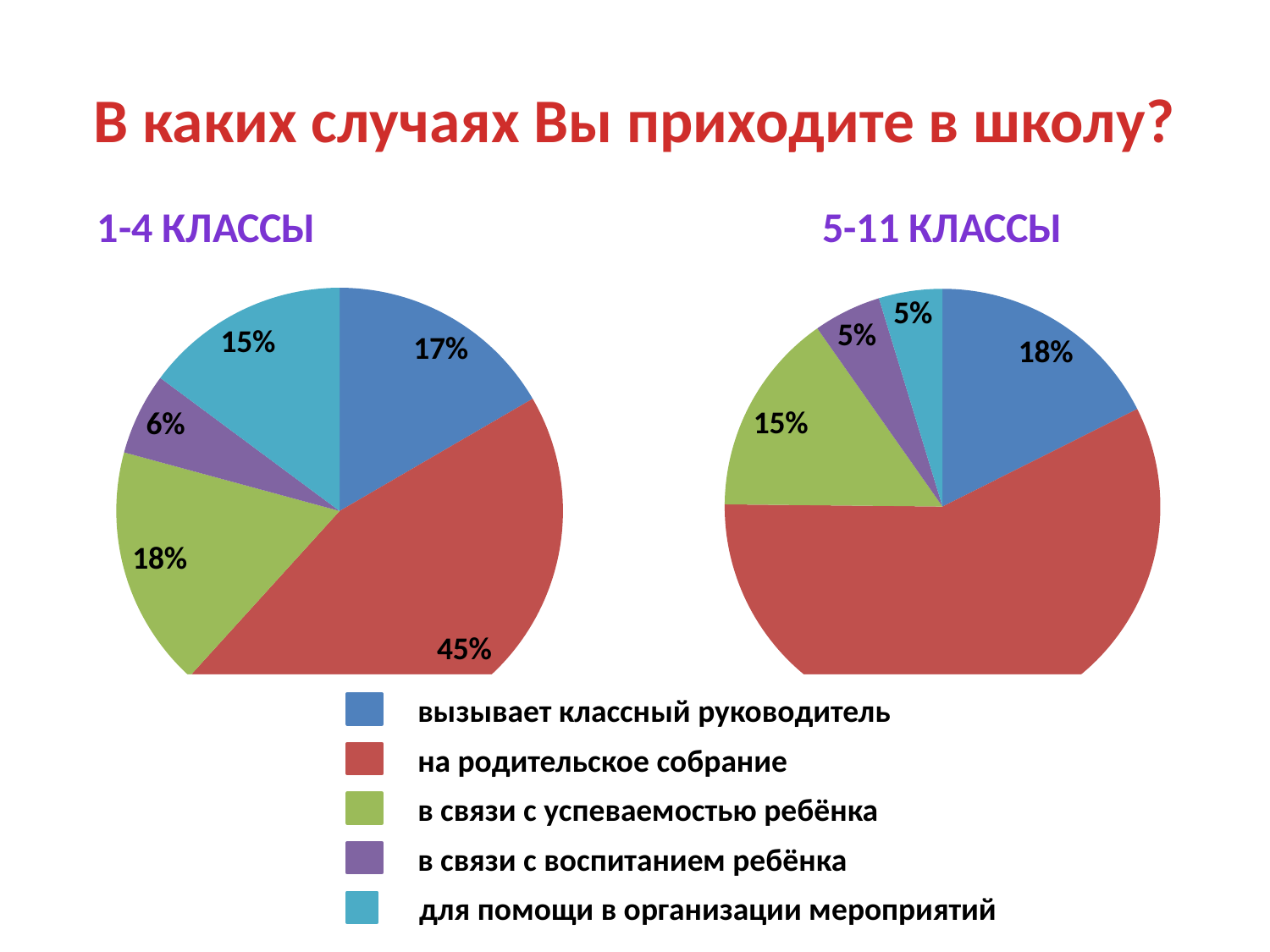
What colour represents 'для помощи в организации мероприятий' in the legend? cyan (light blue) In the 5-11 КЛАССЫ chart, what percentage is shown for 'вызывает классный руководитель'? 18% In the 1-4 КЛАССЫ chart, what is the difference in percentage points between 'на родительское собрание' and 'вызывает классный руководитель'? 28 How many categories does the legend list? 5 In the 1-4 КЛАССЫ chart, which category has the largest slice? на родительское собрание What kind of chart is used on the slide for the 1-4 КЛАССЫ data? pie chart In the 1-4 КЛАССЫ chart, which is larger: 'в связи с успеваемостью ребёнка' or 'для помощи в организации мероприятий'? в связи с успеваемостью ребёнка In the 1-4 КЛАССЫ chart, what percentage is shown for 'в связи с воспитанием ребёнка'? 6% In the 5-11 КЛАССЫ chart, which category has the largest slice? на родительское собрание In the 1-4 КЛАССЫ chart, what percentage is shown for 'на родительское собрание'? 45% In the 1-4 КЛАССЫ chart, which category has the smallest slice? в связи с воспитанием ребёнка In the 5-11 КЛАССЫ chart, what percentage is shown for 'в связи с успеваемостью ребёнка'? 15%